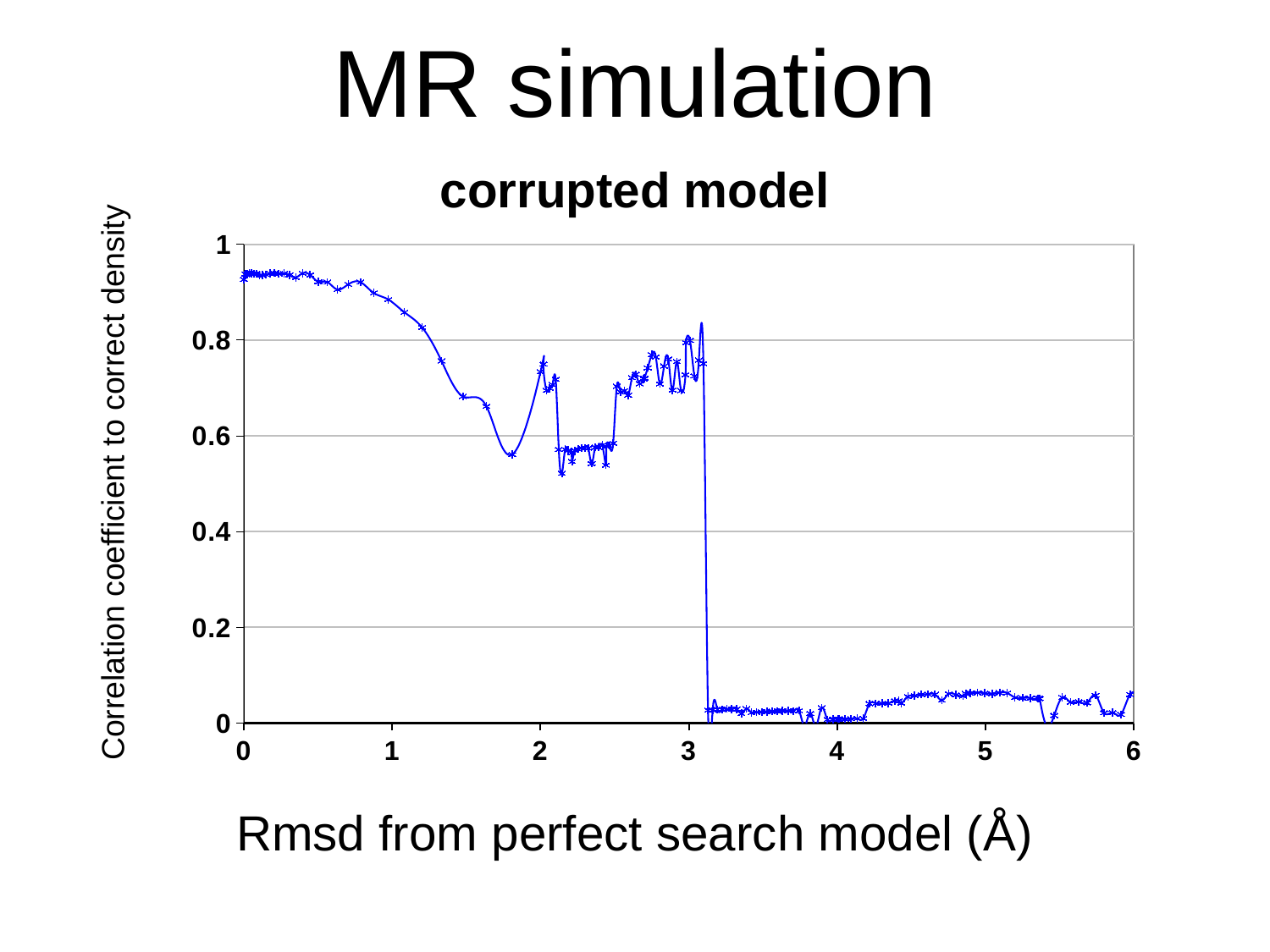
Is the correlation coefficient at an rmsd of 0 Å greater or less than 0.8? greater Does the correlation coefficient rise or fall as the rmsd increases from 0 to 1 Å? fall How many data series are plotted on the chart? 1 What kind of chart is shown on the slide? line chart Is the correlation coefficient at an rmsd of 3 Å greater or less than 0.6? greater What is the title of the chart? corrupted model Is the correlation coefficient at an rmsd of 5 Å greater or less than 0.2? less What is the label of the y axis of the chart? Correlation coefficient to correct density Is the correlation coefficient at an rmsd of 5 Å larger or smaller than at an rmsd of 1 Å? smaller Overall, does the correlation coefficient rise or fall as the rmsd increases from 0 to 6 Å? fall